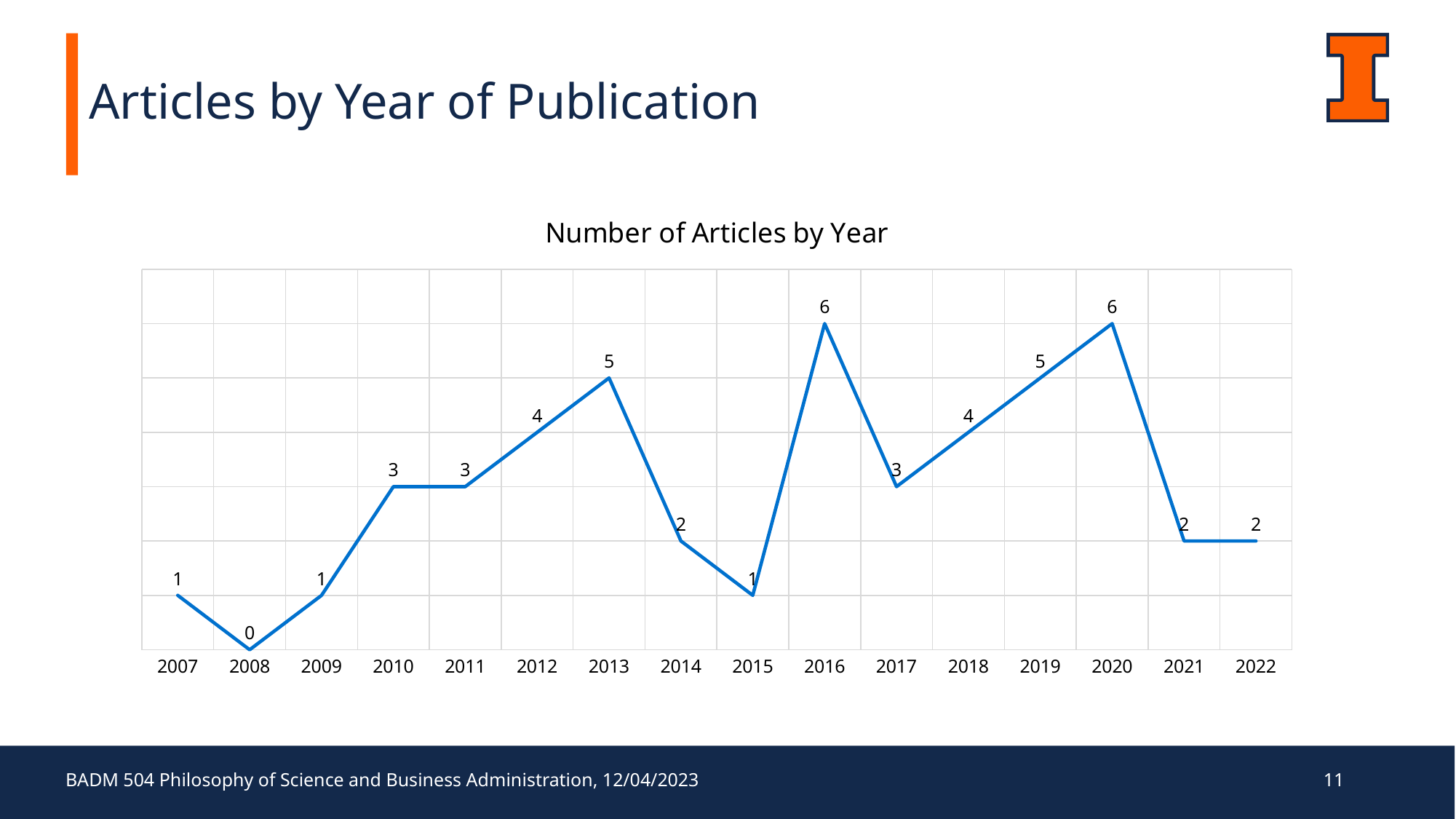
What is the number of articles for 2017? 3 How many years are plotted on the x axis? 16 Which year has more articles, 2019 or 2014? 2019 What is the difference between the number of articles in 2020 and in 2021? 4 What is the difference between the number of articles in 2016 and in 2015? 5 What type of chart is shown on the slide? Line chart What is the value shown for 2022? 2 Do the values rise or fall from 2017 to 2020? Rise What is the highest number of articles shown in any year? 6 What is the title of the chart? Number of Articles by Year Which year has the lowest number of articles? 2008 How many articles were published in 2013? 5